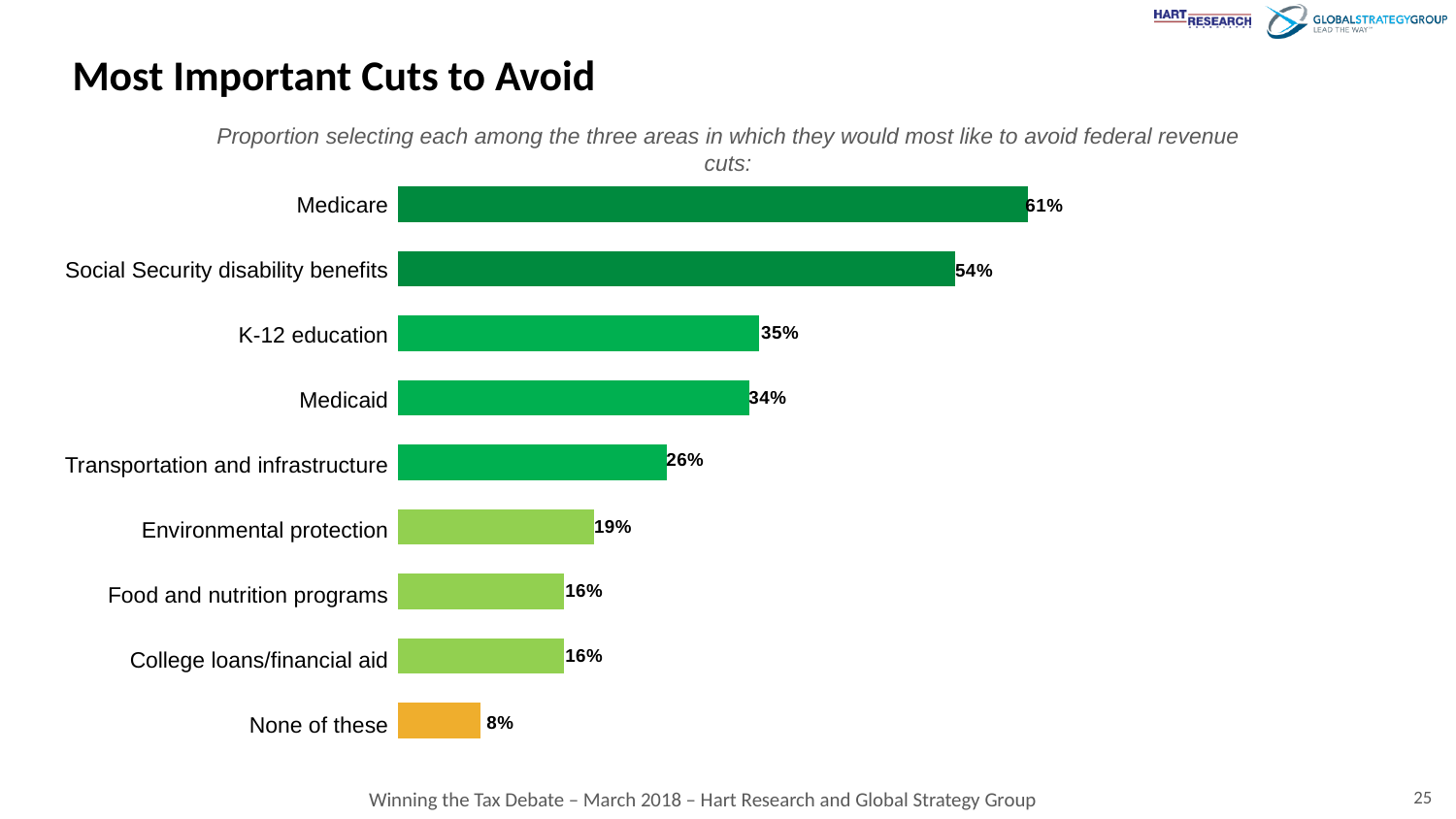
What is the difference between the values for K-12 education and Environmental protection? 16% What percentage selected Medicare as an area in which they would most like to avoid federal revenue cuts? 61% Which category has the lowest value on the chart? None of these What is the title of the slide? Most Important Cuts to Avoid Which category has the highest value on the chart? Medicare What is the difference between the values for Medicare and Social Security disability benefits? 7% Which has a larger value, Medicaid or Transportation and infrastructure? Medicaid What percentage selected None of these? 8% How many categories are shown on the chart? 9 What kind of chart is shown on the slide? Bar chart Which has a larger value, Social Security disability benefits or K-12 education? Social Security disability benefits What is the value shown for Transportation and infrastructure? 26%